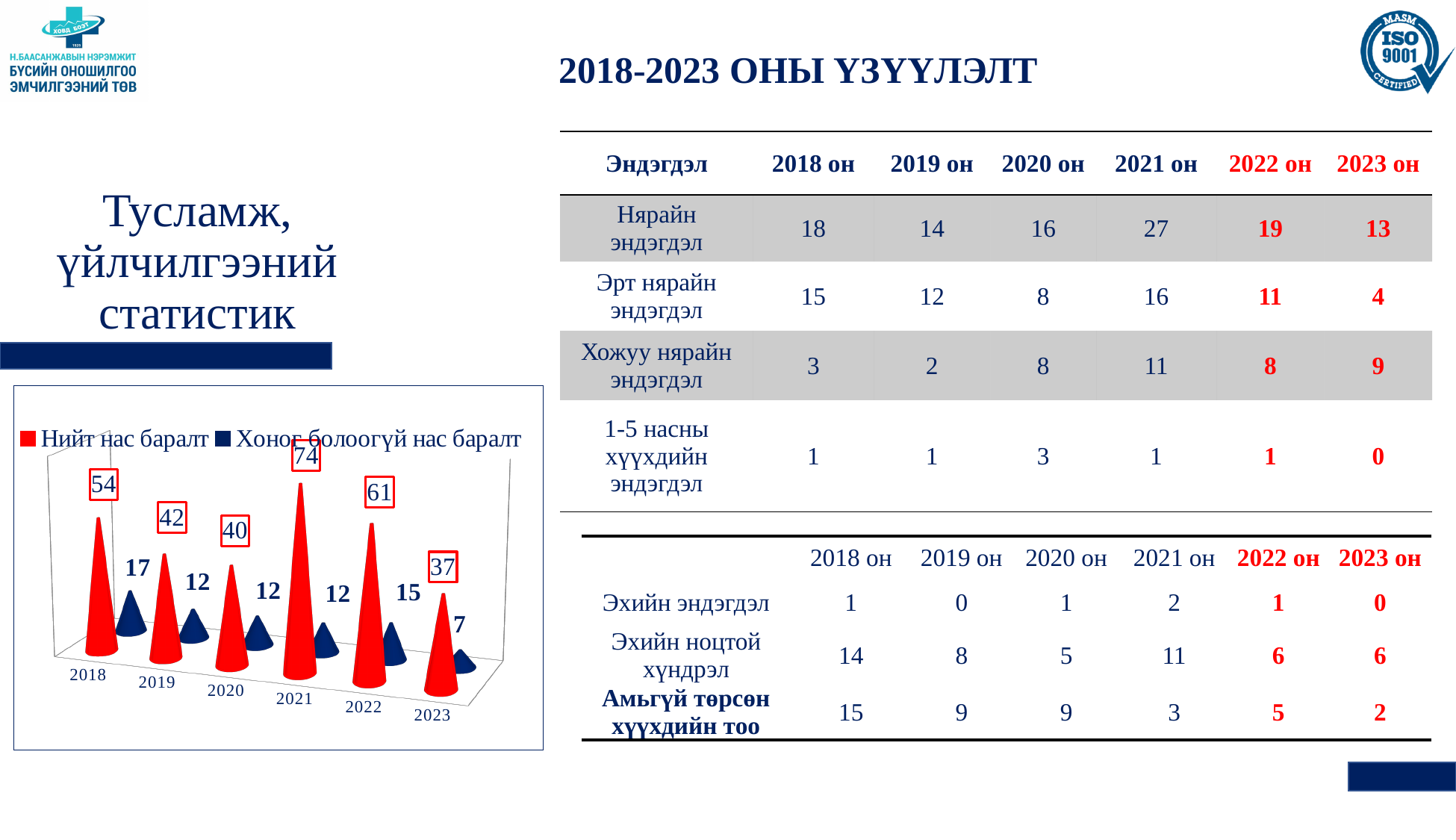
What is the value of Нийт нас баралт for 2023? 37 In which year is Нийт нас баралт highest? 2021 Which colour represents Хоног болоогүй нас баралт in the chart? dark blue What is the value of Хоног болоогүй нас баралт for 2018? 17 What is the value of Нийт нас баралт for 2021? 74 What kind of chart is shown on the slide? bar chart How many series does the chart legend list? 2 In which year is Хоног болоогүй нас баралт lowest? 2023 How many years are shown on the x axis of the chart? 6 What is the difference between Нийт нас баралт in 2021 and in 2022? 13 Which is larger, Нийт нас баралт in 2019 or in 2020? 2019 What is the difference between Нийт нас баралт and Хоног болоогүй нас баралт in 2018? 37